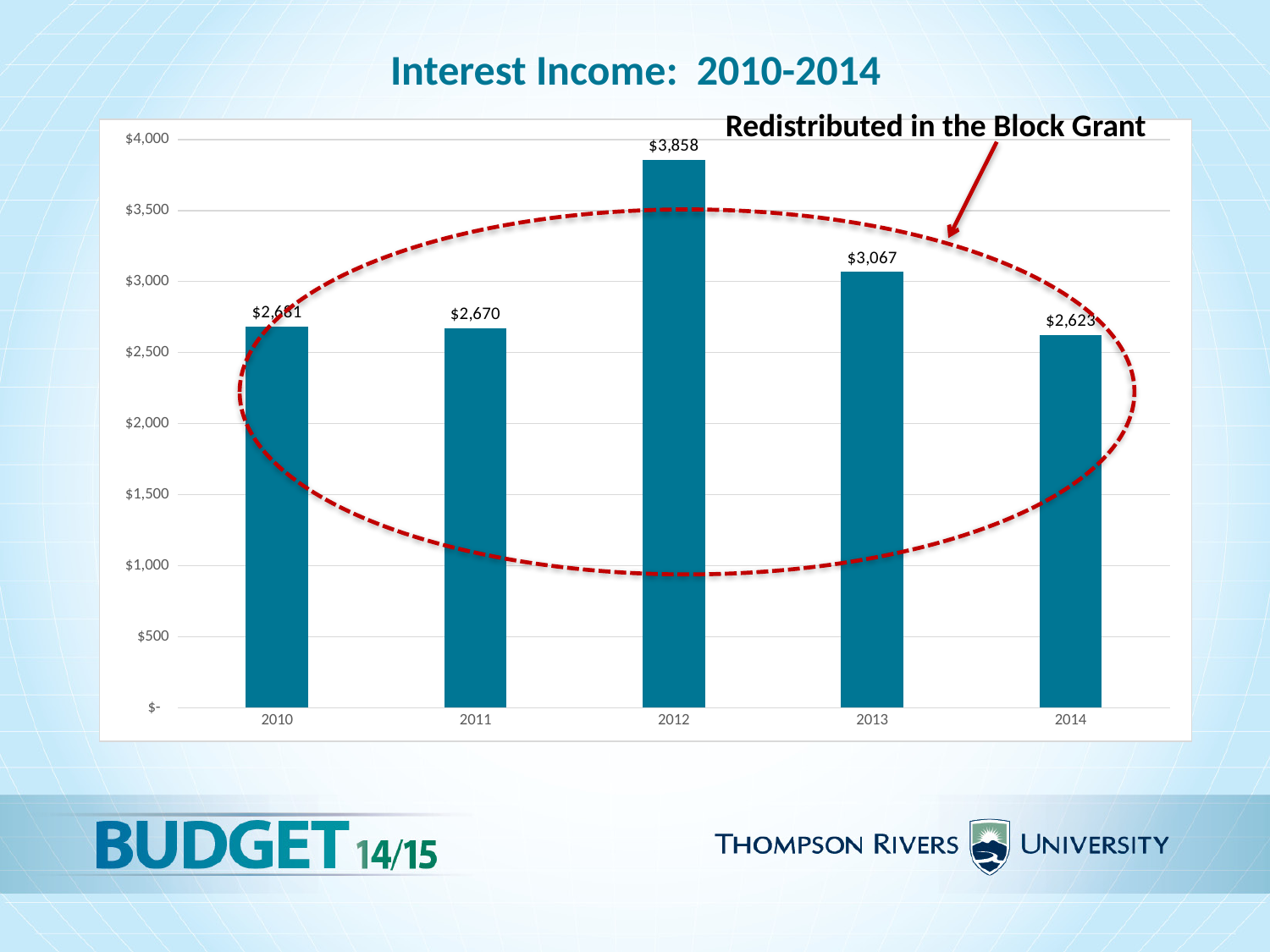
What is the interest income value shown for 2011? $2,670 What is the difference between the 2012 and 2013 interest income values? $791 What is the interest income value shown for 2012? $3,858 Is the value for 2010 greater or less than $2,500? greater What is the interest income value shown for 2014? $2,623 Which year has the highest interest income? 2012 How many years are shown on the x axis of the chart? 5 What is the interest income value shown for 2013? $3,067 Which year has the larger interest income, 2012 or 2013? 2012 What kind of chart is shown on the slide? bar chart What is the difference between the 2013 and 2014 interest income values? $444 What does the red annotation text above the chart say? Redistributed in the Block Grant